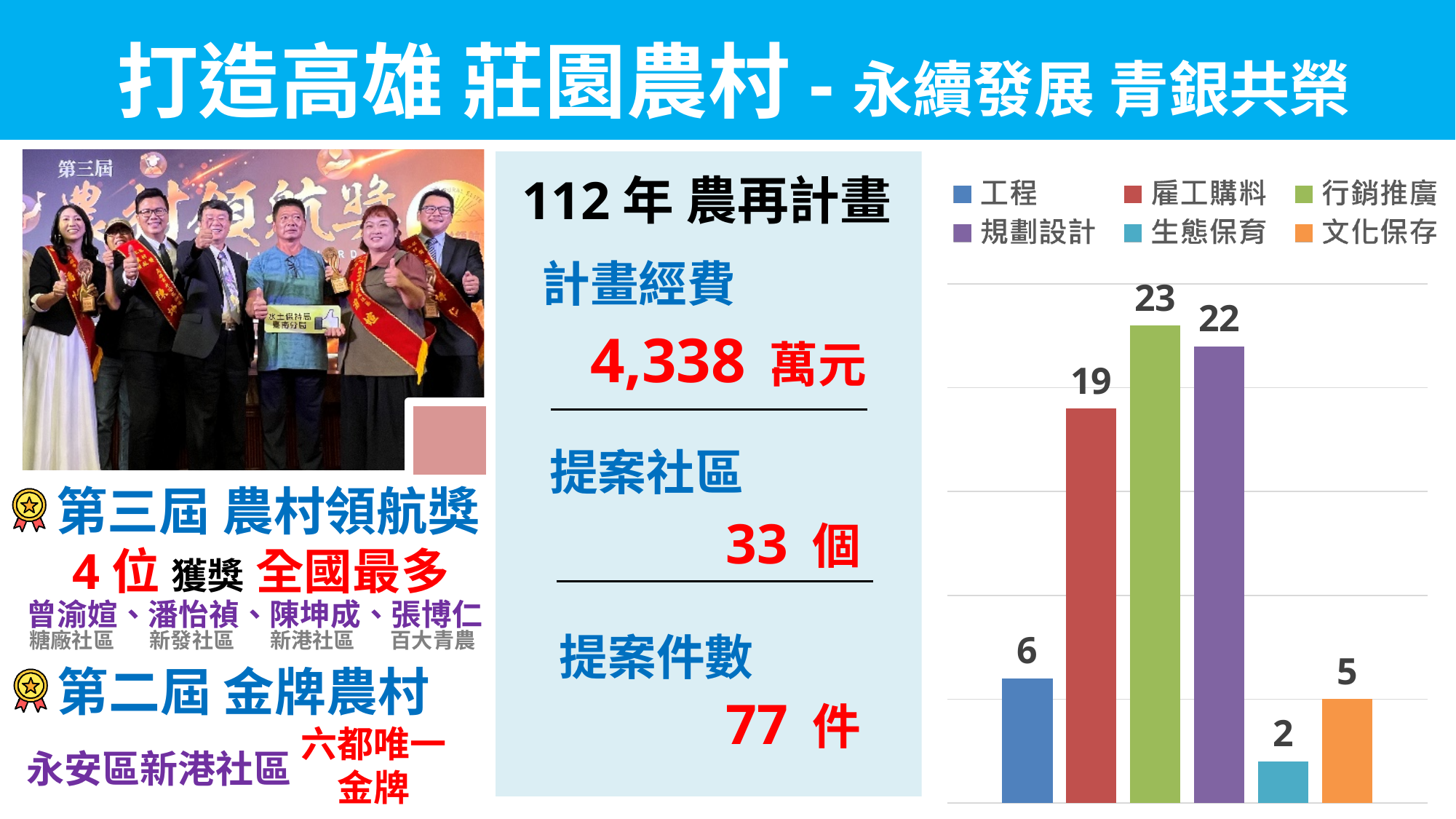
What is the value for 行銷推廣 in the bar chart? 23 What is the difference between the values for 雇工購料 and 工程? 13 What is the value for 工程 in the bar chart? 6 What is the value for 雇工購料 in the bar chart? 19 Which category has the lowest value in the bar chart? 生態保育 What is the sum of all the bar values in the chart? 77 What kind of chart is shown on the slide? bar chart What is the value for 生態保育 in the bar chart? 2 Which is larger, the value for 規劃設計 or the value for 文化保存? 規劃設計 How many entries does the chart legend list? 6 How many bars are shown in the chart? 6 Which category has the highest value in the bar chart? 行銷推廣